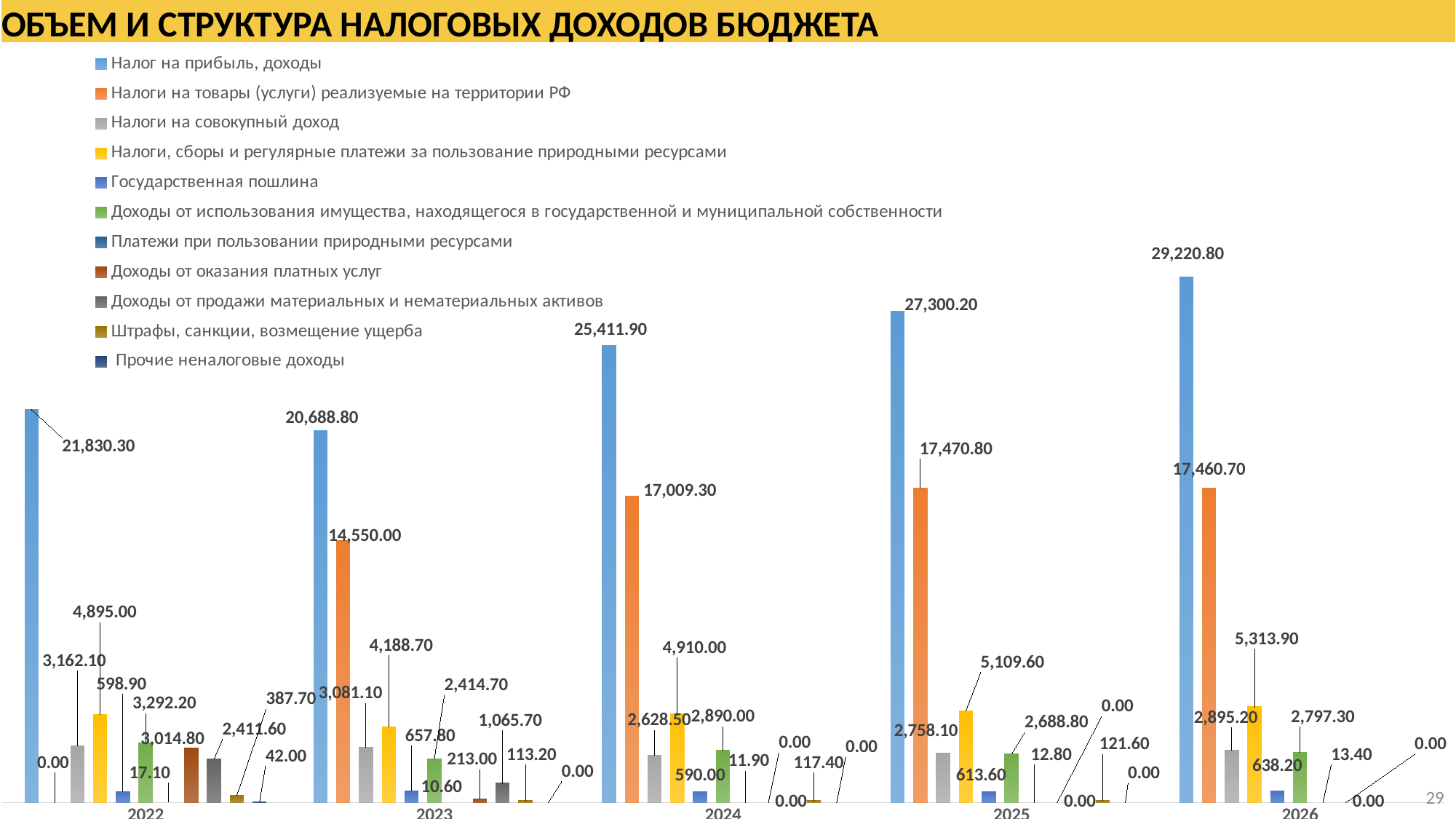
What is the value of 'Налоги, сборы и регулярные платежи за пользование природными ресурсами' for 2024? 4,910.00 What is the value of 'Налоги на товары (услуги) реализуемые на территории РФ' for 2023? 14,550.00 How many series does the legend list? 11 What kind of chart is shown on the slide? Bar chart How many years (categories) are shown on the x axis? 5 What is the value of 'Налог на прибыль, доходы' for 2026? 29,220.80 What is the title of the chart? ОБЪЕМ И СТРУКТУРА НАЛОГОВЫХ ДОХОДОВ БЮДЖЕТА Which is larger: 'Налоги, сборы и регулярные платежи за пользование природными ресурсами' in 2026 or in 2025? 2026 In which year is 'Налог на прибыль, доходы' lowest? 2023 Does 'Налог на прибыль, доходы' rise or fall from 2024 to 2026? Rise In which year is 'Налог на прибыль, доходы' highest? 2026 What is the difference between the 'Налог на прибыль, доходы' values for 2026 and 2025? 1,920.60